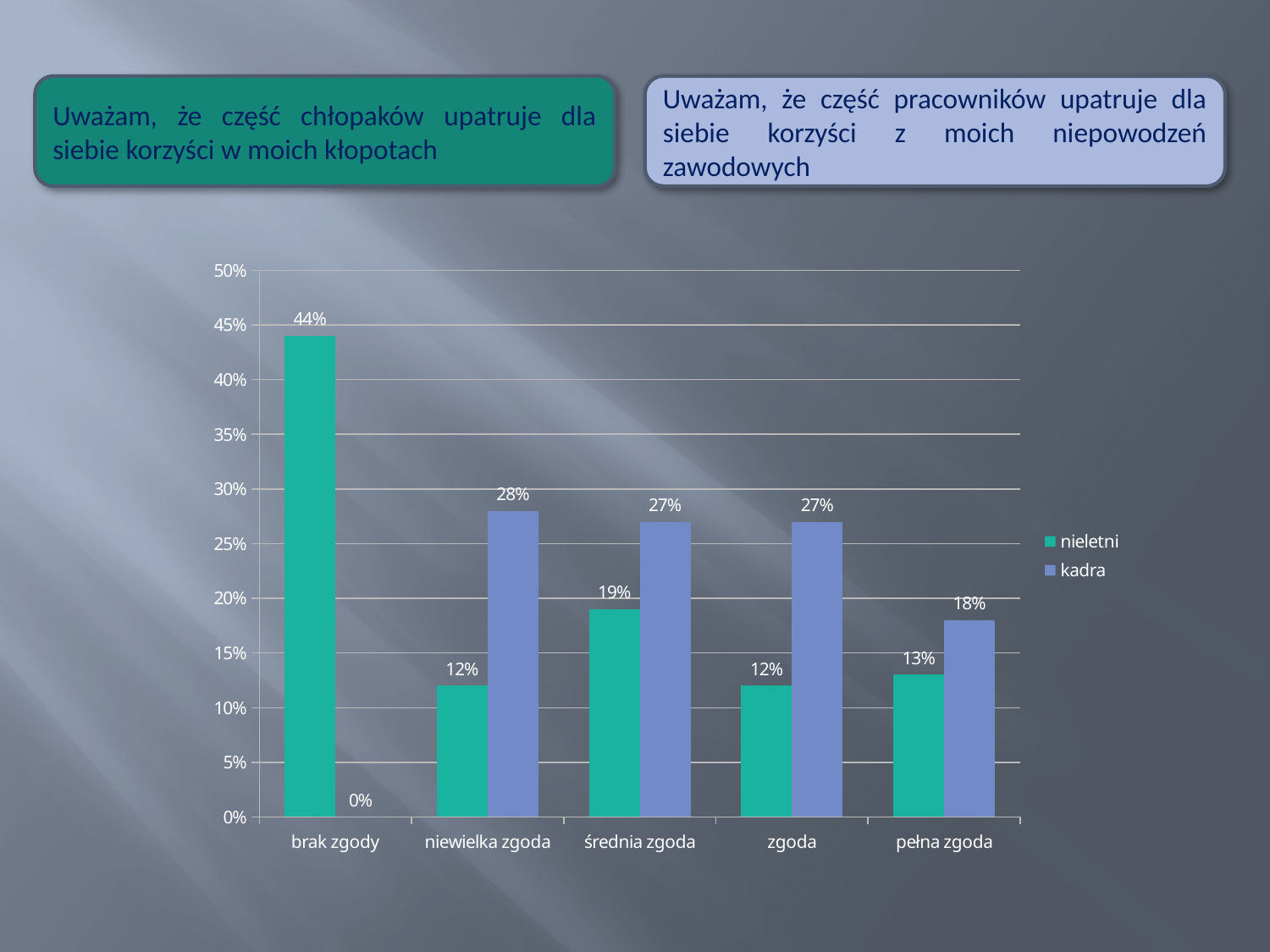
What is the value for nieletni in the brak zgody category? 44% In the średnia zgoda category, which series has the larger value, nieletni or kadra? kadra What is the value for kadra in the niewielka zgoda category? 28% What is the difference between the nieletni and kadra values in the zgoda category? 15% What kind of chart is shown on the slide? bar chart How many series does the legend list? 2 Which category has the lowest value for kadra? brak zgody How many categories are shown on the x axis? 5 What is the value for kadra in the brak zgody category? 0% What is the value for nieletni in the pełna zgoda category? 13% Which colour represents the kadra series? blue Which category has the highest value for nieletni? brak zgody